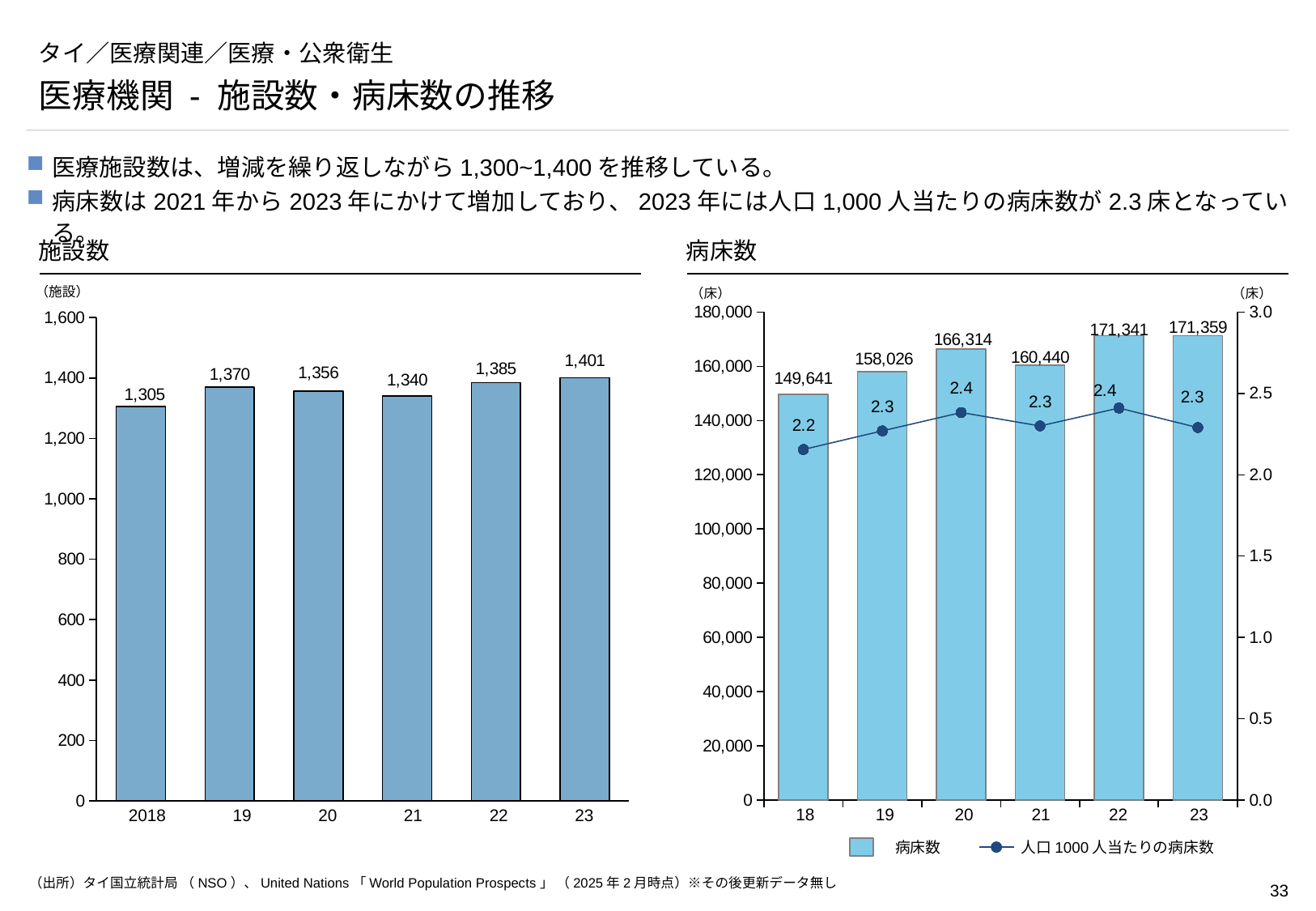
In the 病床数 chart on the right, what is the 病床数 value for 20? 166,314 In the 施設数 chart on the left, which year has the highest value? 23 In the 病床数 chart on the right, which year has the lowest 病床数 bar? 18 In the 施設数 chart on the left, what is the difference between the values for 23 and 2018? 96 In the 病床数 chart on the right, what is the difference between the 病床数 values for 22 and 21? 10,901 In the 施設数 chart on the left, what is the value for 2018? 1,305 In the 施設数 chart on the left, how many years are plotted? 6 In the 病床数 chart on the right, which is larger, the 病床数 value for 19 or for 21? 21 In the 施設数 chart on the left, which year has the lowest value? 2018 How many series does the legend of the 病床数 chart on the right list? 2 What kind of chart is the 施設数 chart on the left? Bar chart In the 病床数 chart on the right, what is the 人口1000人当たりの病床数 value for 23? 2.3